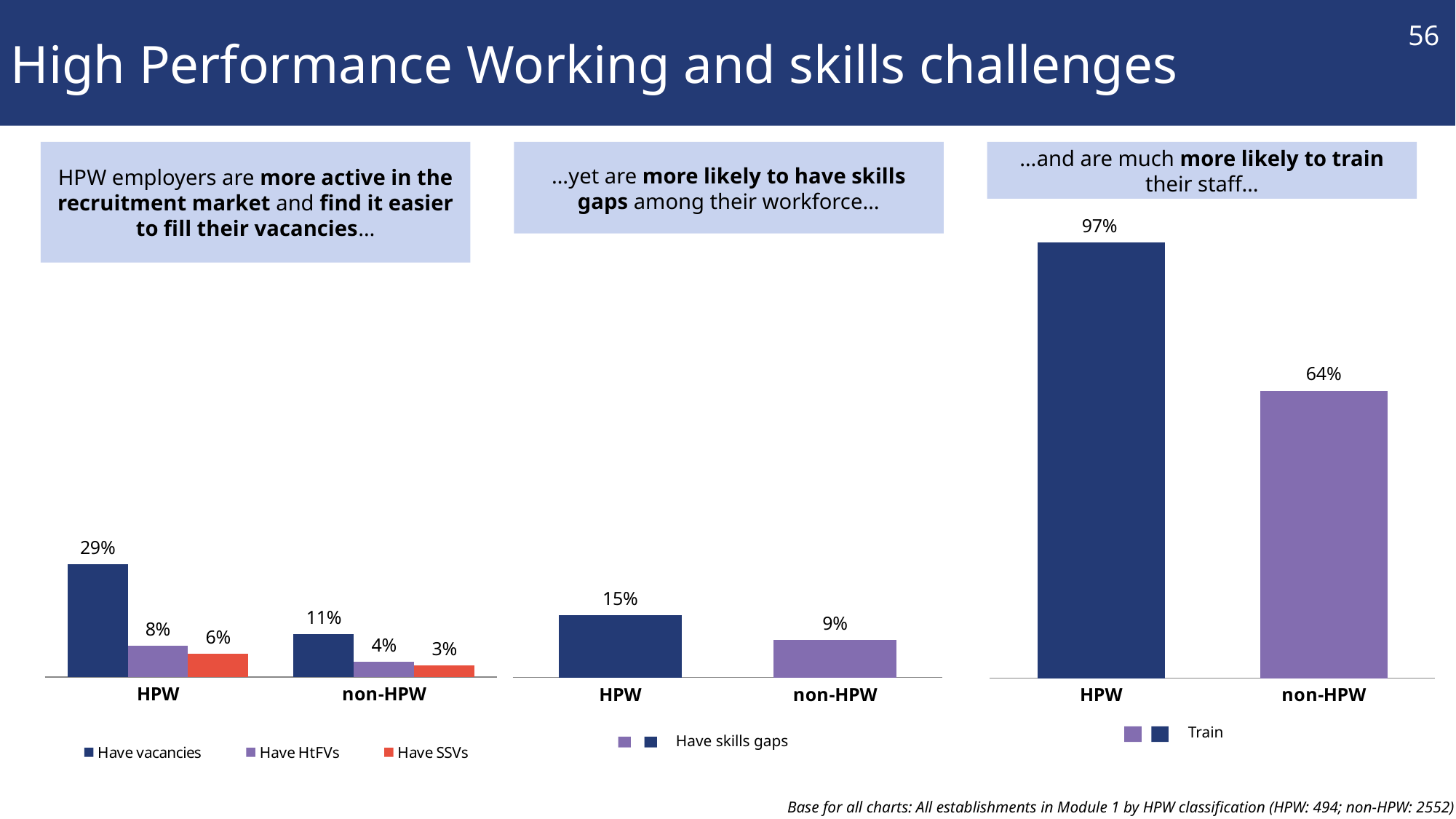
What kind of chart is the right chart? Bar chart In the middle chart, which category has the lower value for Have skills gaps? non-HPW In the right chart, which category has the higher value for Train? HPW In the left chart, what is the value for Have HtFVs for non-HPW? 4% In the right chart, what is the value for Train for non-HPW? 64% In the middle chart, what is the difference between the HPW and non-HPW values? 6% In the left chart, how many series does the legend list? 3 In the left chart, what is the value for Have vacancies for HPW? 29% In the middle chart, what is the value for Have skills gaps for HPW? 15% In the left chart, what is the value for Have SSVs for HPW? 6% In the left chart, what is the difference between Have vacancies for HPW and for non-HPW? 18% In the right chart, what is the difference between the HPW and non-HPW values for Train? 33%